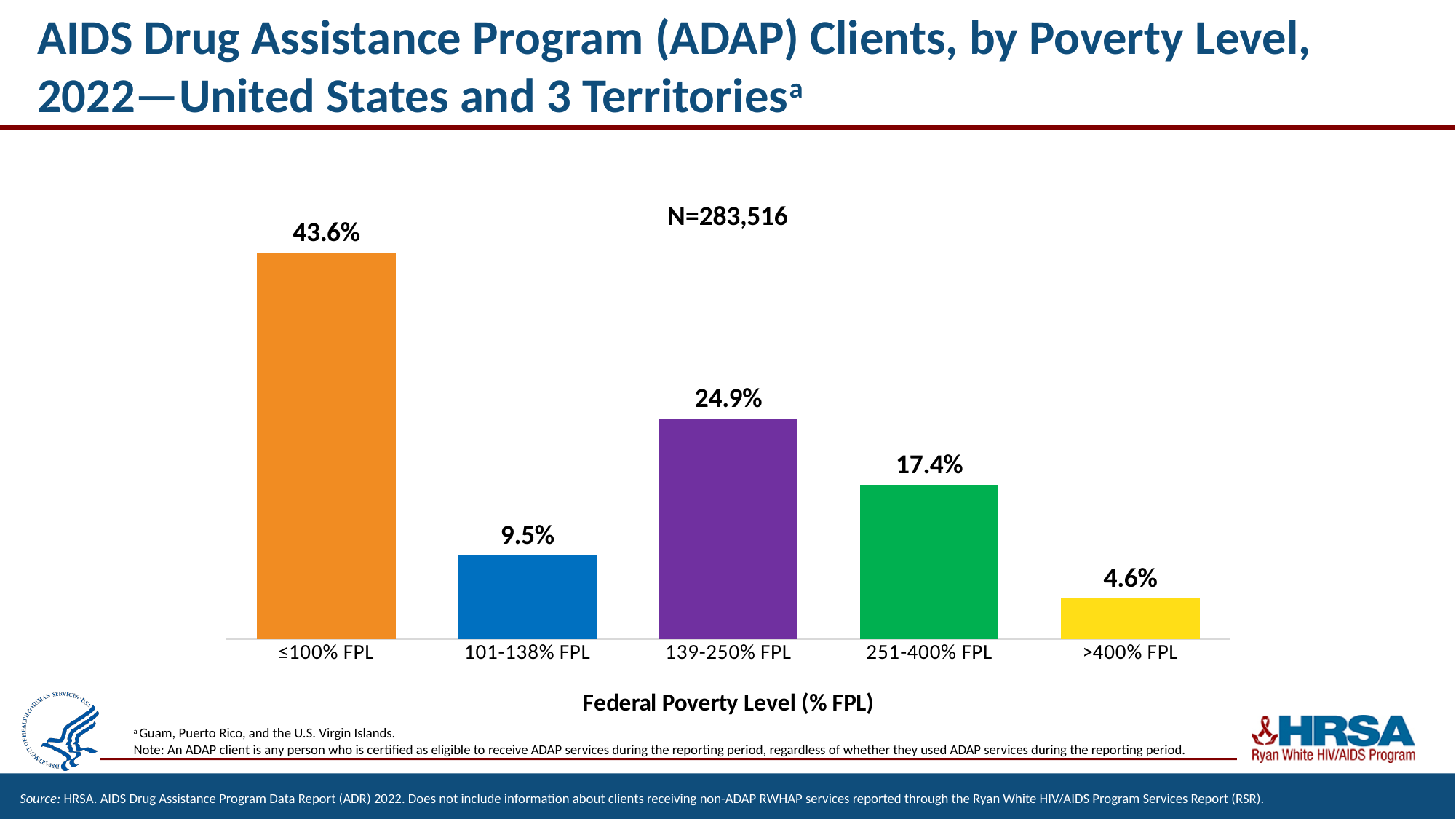
What percentage of ADAP clients are at >400% FPL? 4.6% What percentage of ADAP clients are at 101-138% FPL? 9.5% What is the x-axis title of the chart? Federal Poverty Level (% FPL) What percentage of ADAP clients are at 139-250% FPL? 24.9% Which poverty level category has the highest percentage of ADAP clients? ≤100% FPL Which poverty level category has the lowest percentage of ADAP clients? >400% FPL Which category has a larger share of ADAP clients, 101-138% FPL or 251-400% FPL? 251-400% FPL What percentage of ADAP clients are at ≤100% FPL? 43.6% How many poverty level categories are shown in the chart? 5 What type of chart is shown on the slide? Bar chart What is the difference in percentage points between the ≤100% FPL and 139-250% FPL categories? 18.7 What is the total number of ADAP clients (N) shown on the chart? 283,516